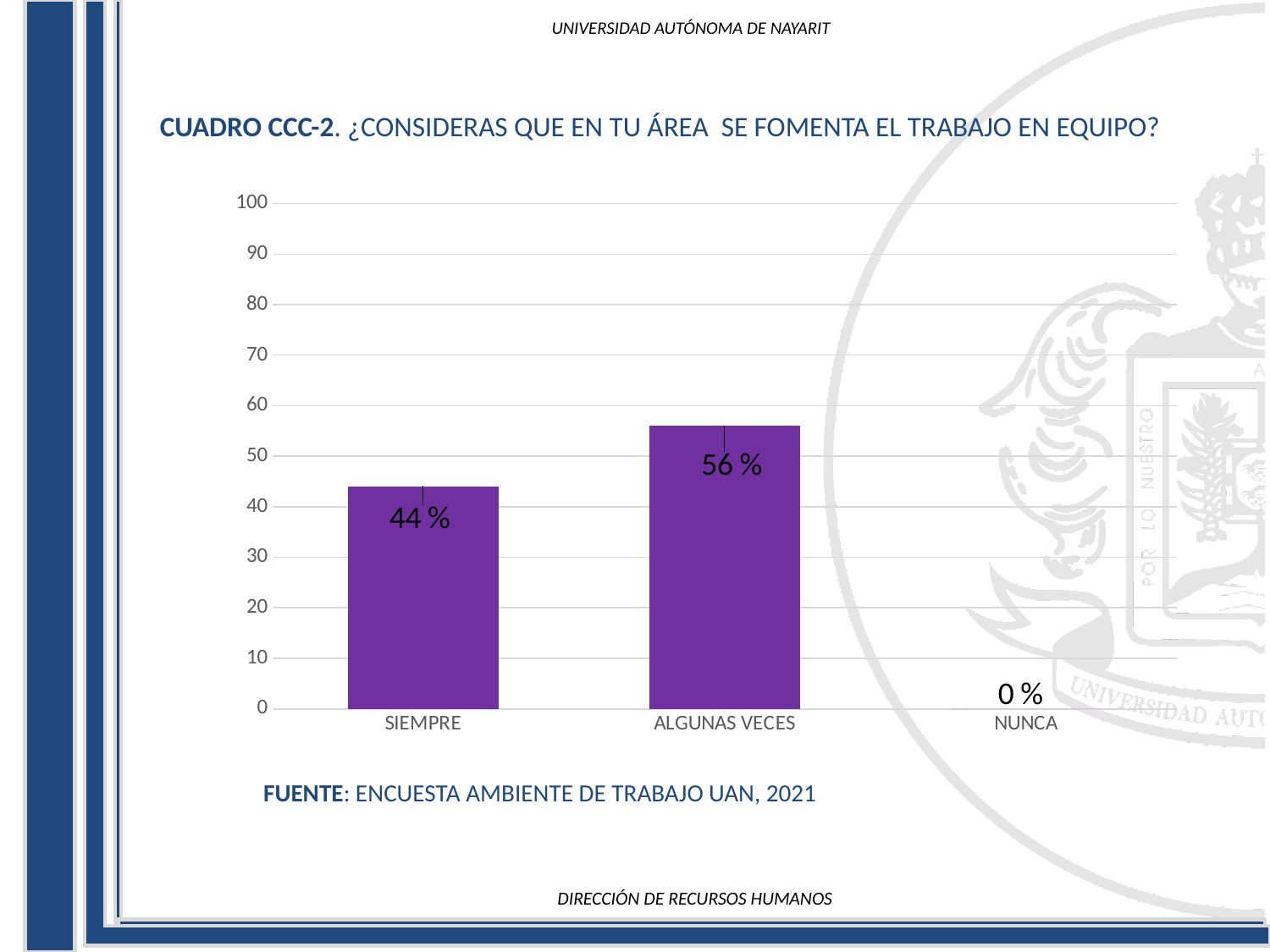
Is the value for ALGUNAS VECES greater or less than 50? greater What is the value for ALGUNAS VECES? 56 % What is the value for SIEMPRE? 44 % What is the difference between the values for ALGUNAS VECES and SIEMPRE? 12 % Which is larger, the value for SIEMPRE or the value for ALGUNAS VECES? ALGUNAS VECES Which category has the highest value? ALGUNAS VECES What is the source cited below the chart? ENCUESTA AMBIENTE DE TRABAJO UAN, 2021 How many categories are shown on the x axis? 3 What kind of chart is shown on the slide? bar chart What is the value for NUNCA? 0 % Is the value for SIEMPRE greater or less than 50? less Which category has the lowest value? NUNCA